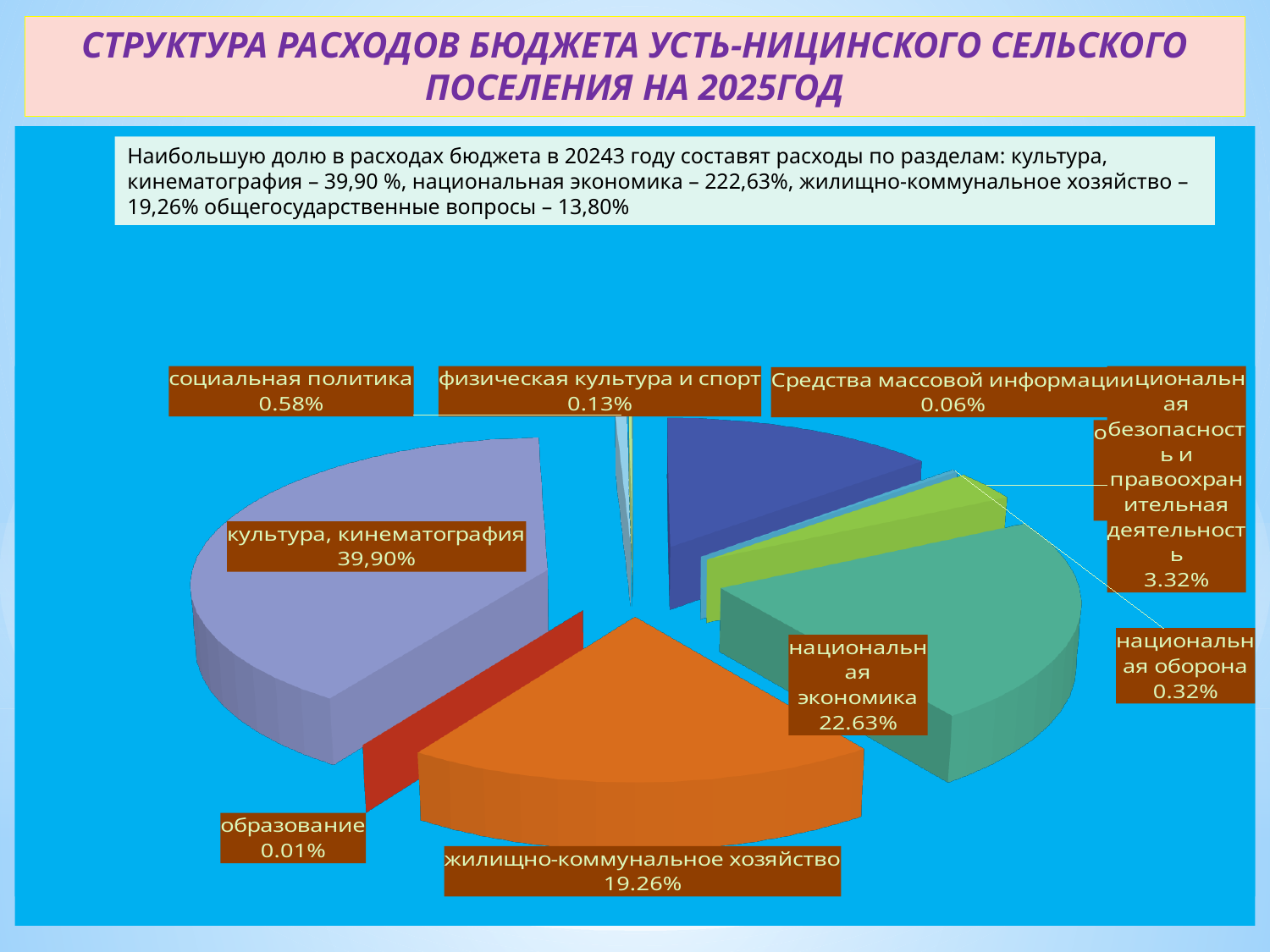
Which is larger: the share for 'национальная экономика' or for 'жилищно-коммунальное хозяйство'? национальная экономика What kind of chart is shown on the slide? pie chart What percentage is shown for 'Средства массовой информации'? 0.06% Which labeled category has the largest share of the pie? культура, кинематография What percentage is shown for 'жилищно-коммунальное хозяйство'? 19.26% What percentage is shown for 'национальная экономика'? 22.63% What percentage is shown for 'физическая культура и спорт'? 0.13% What percentage is shown for 'образование'? 0.01% What percentage is shown for 'социальная политика'? 0.58% What share of the budget expenditures does the slice 'культура, кинематография' represent? 39,90% Which labeled category has the smallest share of the pie? образование What percentage is shown for 'национальная оборона'? 0.32%